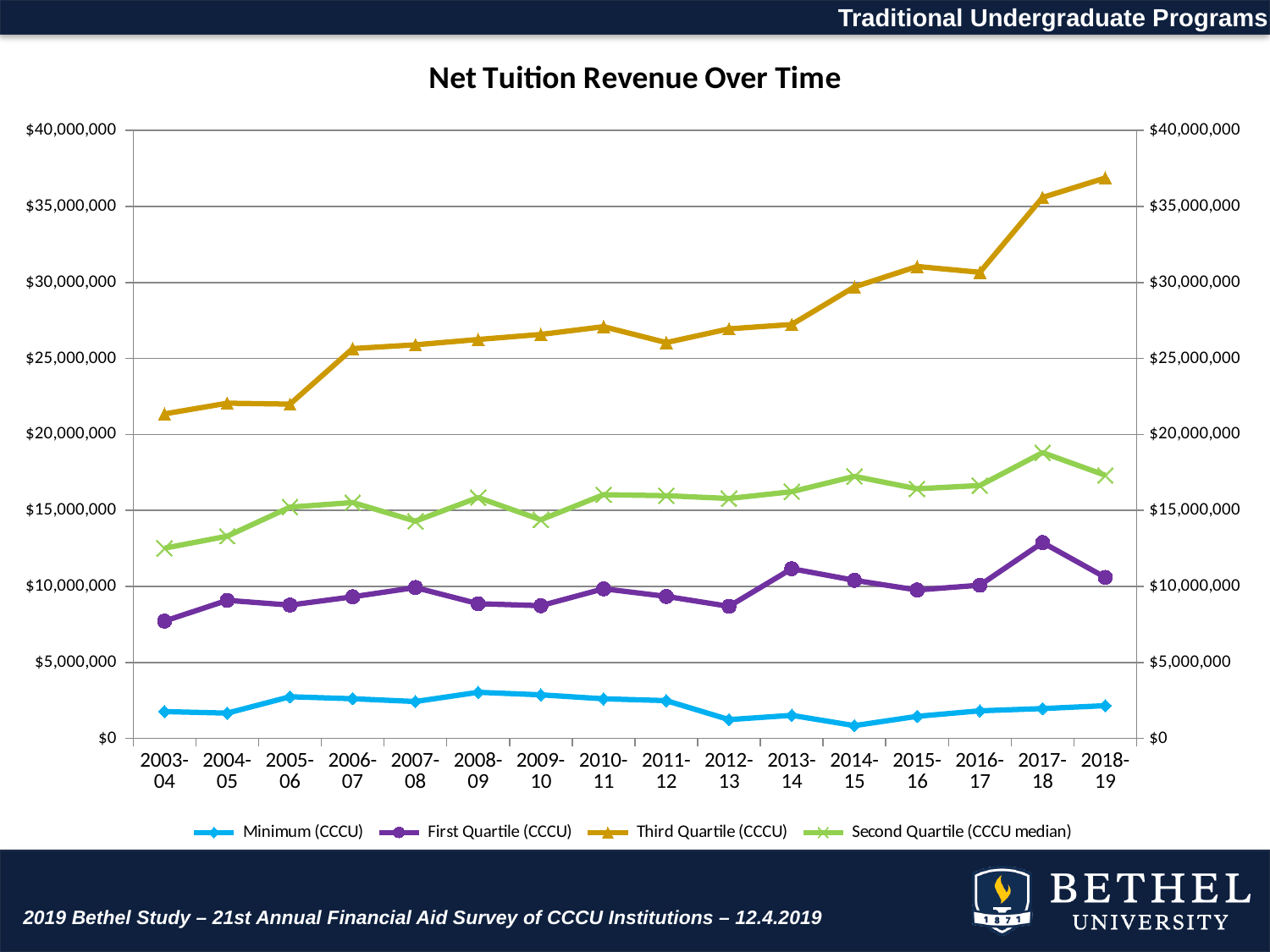
Which series has the highest values across all years? Third Quartile (CCCU) Which series has the lowest values across all years? Minimum (CCCU) Which is larger for the Third Quartile (CCCU) series: the value for 2016-17 or the value for 2017-18? 2017-18 How many academic years are plotted along the x axis? 16 Is the Third Quartile (CCCU) value for 2018-19 greater or less than $35,000,000? greater Is the First Quartile (CCCU) value for 2003-04 greater or less than $10,000,000? less Does the Third Quartile (CCCU) line generally rise or fall from 2003-04 to 2018-19? rise In which year does the First Quartile (CCCU) series reach its highest value? 2017-18 Is the Second Quartile (CCCU median) value for 2017-18 greater or less than $20,000,000? less What is the title of the chart? Net Tuition Revenue Over Time How many series does the legend list? 4 What kind of chart is shown on the slide? line chart